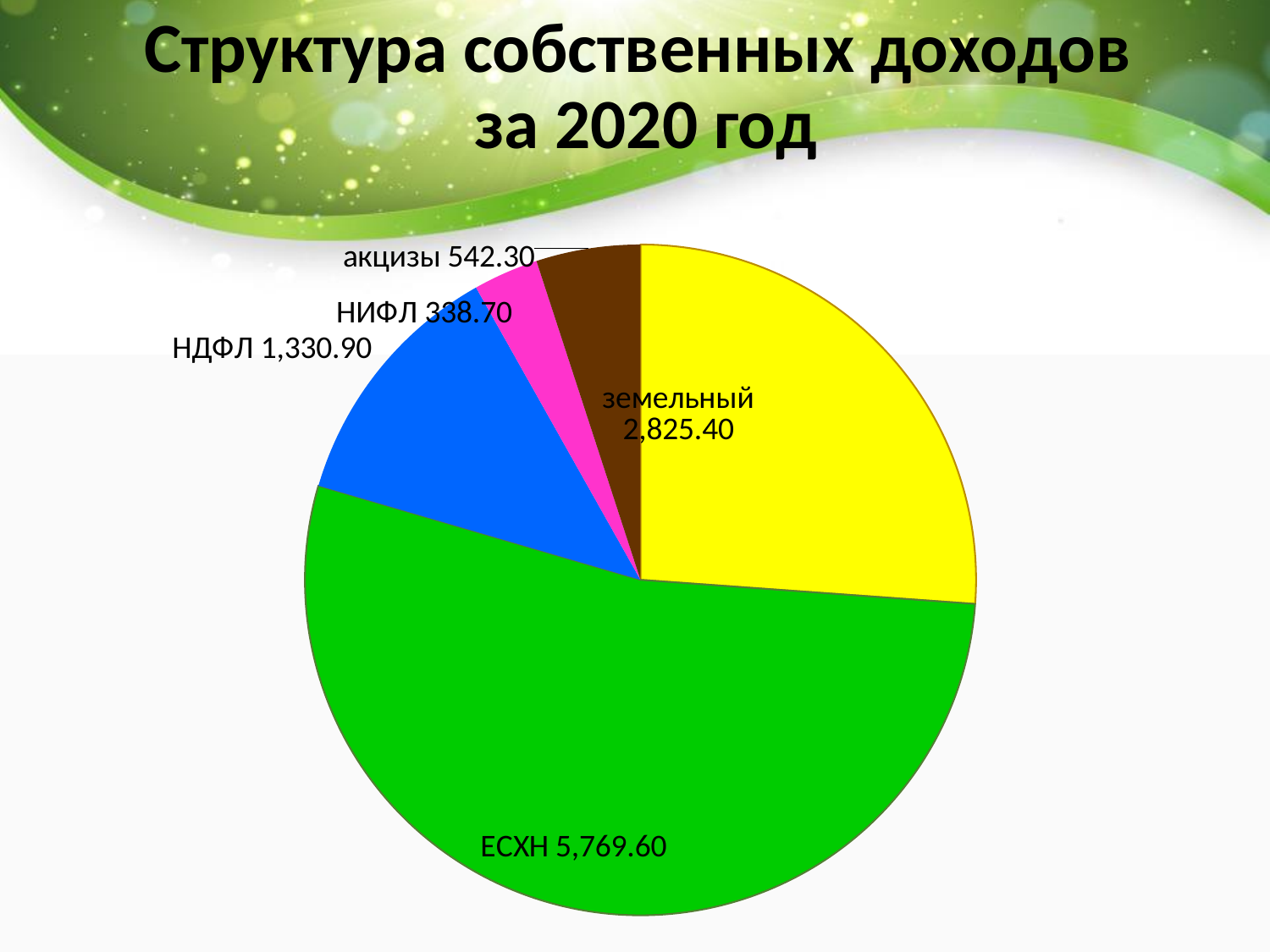
Which category has the largest slice of the pie? ЕСХН What is the value for ЕСХН? 5,769.60 What is the title of the chart? Структура собственных доходов за 2020 год What is the difference between the values for акцизы and НИФЛ? 203.60 Which category has the smallest slice of the pie? НИФЛ What is the value for земельный? 2,825.40 What is the value for акцизы? 542.30 What is the value for НДФЛ? 1,330.90 Which is larger, the value for НДФЛ or the value for акцизы? НДФЛ What kind of chart is shown on the slide? pie chart What is the difference between the values for ЕСХН and земельный? 2,944.20 How many categories are shown in the pie chart? 5